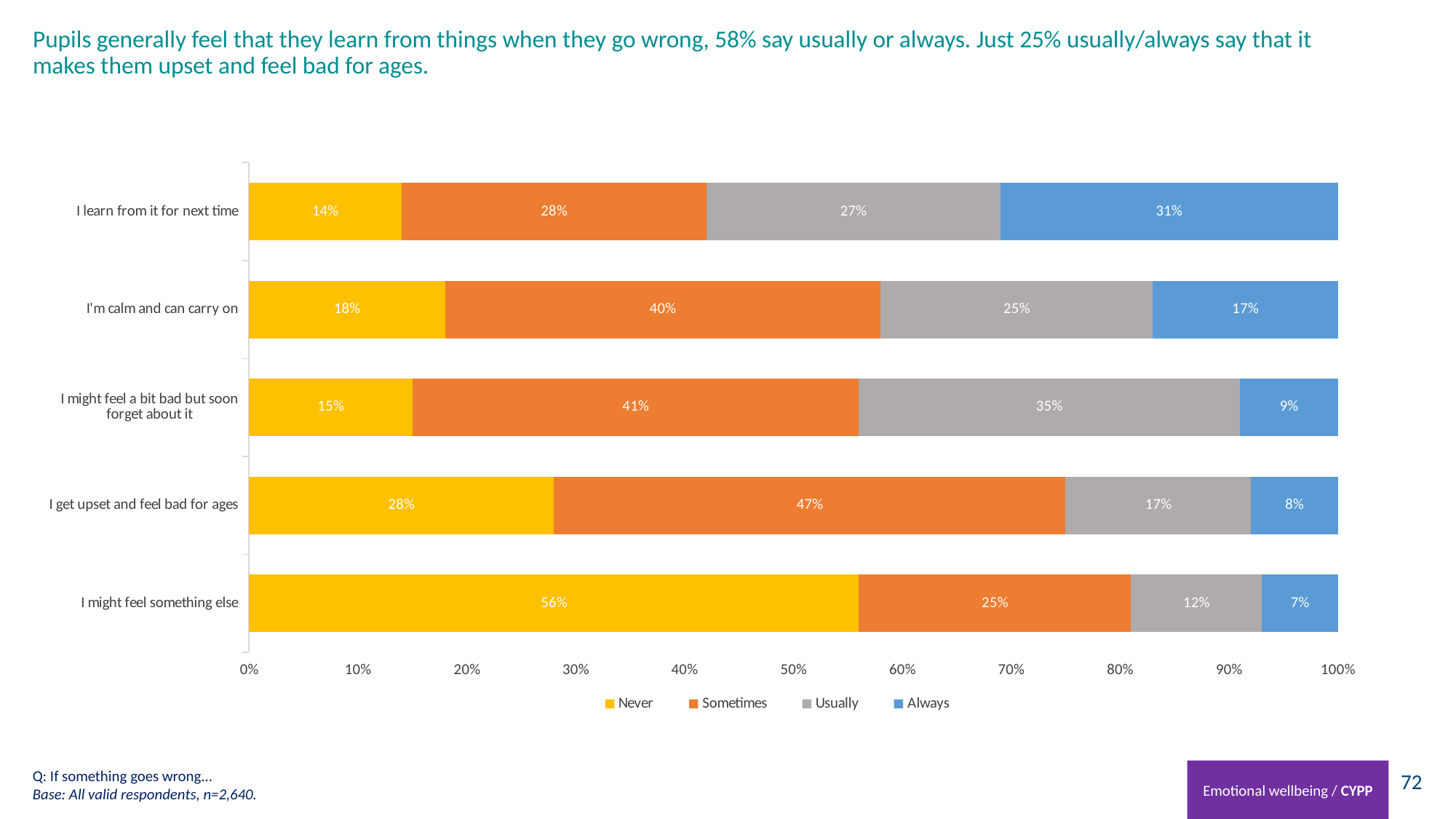
How many statements (categories) are shown on the chart? 5 Which statement has the highest 'Always' value? I learn from it for next time How many series does the legend list? 4 Which colour represents 'Sometimes' in the legend? Orange What is the difference between the 'Sometimes' values for 'I'm calm and can carry on' and 'I might feel something else'? 15% Which statement has the lowest 'Never' value? I learn from it for next time What is the 'Usually' value for 'I might feel a bit bad but soon forget about it'? 35% Which is larger: the 'Usually' value for 'I'm calm and can carry on' or the 'Usually' value for 'I get upset and feel bad for ages'? I'm calm and can carry on What kind of chart is shown on the slide? Stacked bar chart What is the 'Sometimes' value for 'I get upset and feel bad for ages'? 47% What percentage of pupils say they 'Never' feel something else? 56% What percentage of pupils say they 'Always' learn from it for next time? 31%